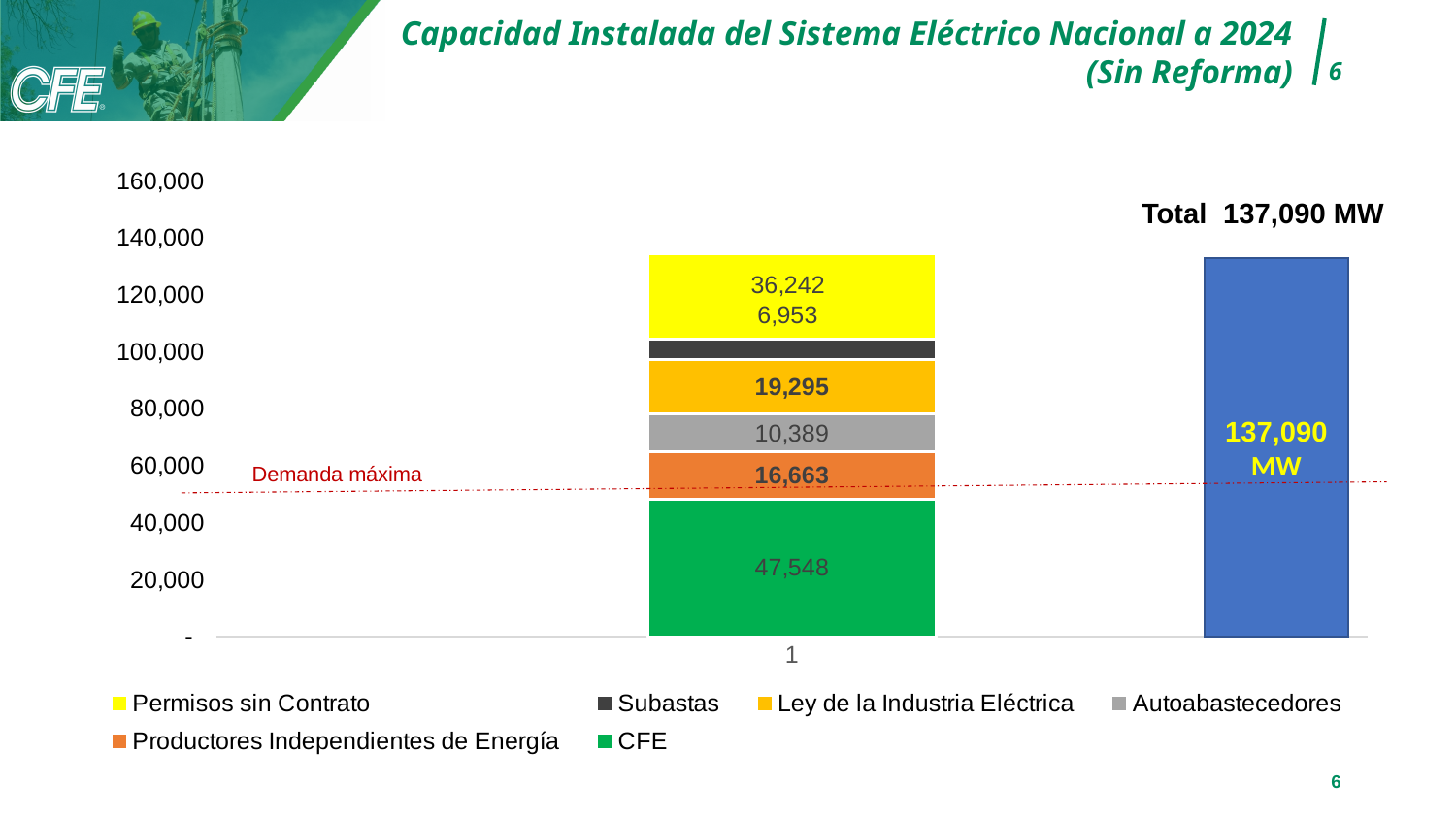
Which series has the smallest segment in the stacked bar? Subastas What is the value of the Permisos sin Contrato segment? 36,242 What is the total installed capacity shown for the stacked bar? 137,090 MW What is the difference between the CFE segment and the Productores Independientes de Energía segment? 30,885 How many series does the legend list? 6 What is the value of the Productores Independientes de Energía segment? 16,663 What is the value of the Autoabastecedores segment? 10,389 Which series has the largest segment in the stacked bar? CFE What is the value of the CFE segment in the stacked bar? 47,548 What is the value of the Ley de la Industria Eléctrica segment? 19,295 What kind of chart is shown on the slide? Stacked bar chart What is the title of the chart on the slide? Capacidad Instalada del Sistema Eléctrico Nacional a 2024 (Sin Reforma)